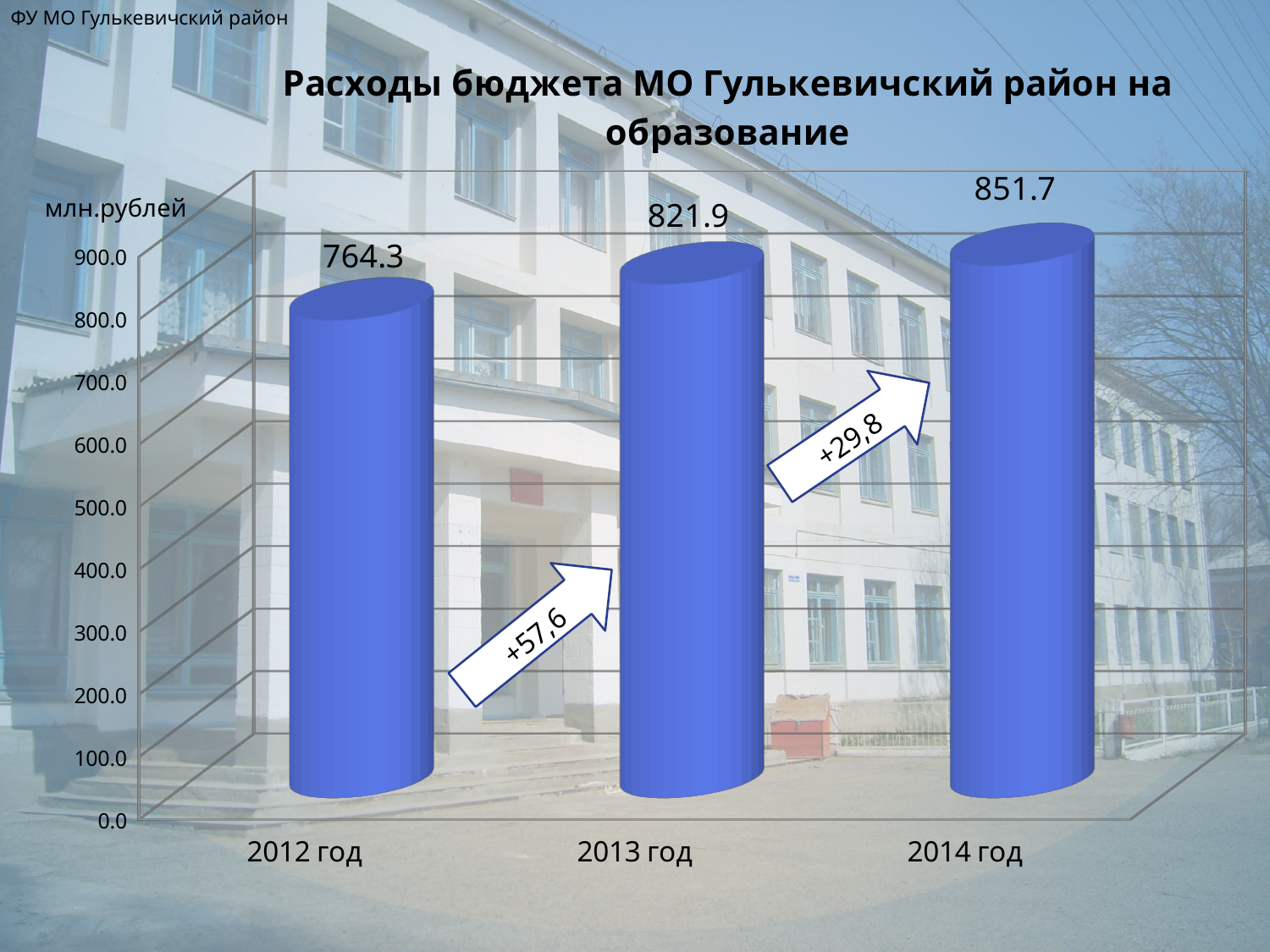
What is the value for 2012 год? 764.3 What is the difference between the values for 2014 год and 2013 год? 29.8 Is the value for 2012 год greater or less than 800.0? less What is the difference between the values for 2013 год and 2012 год? 57.6 What is the value for 2013 год? 821.9 Which year has the highest value? 2014 год What kind of chart is shown on the slide? bar chart Which year has the lowest value? 2012 год Which is larger, the value for 2012 год or the value for 2014 год? 2014 год Do the values rise or fall from 2012 год to 2014 год? rise How many years are shown on the chart? 3 What is the value for 2014 год? 851.7